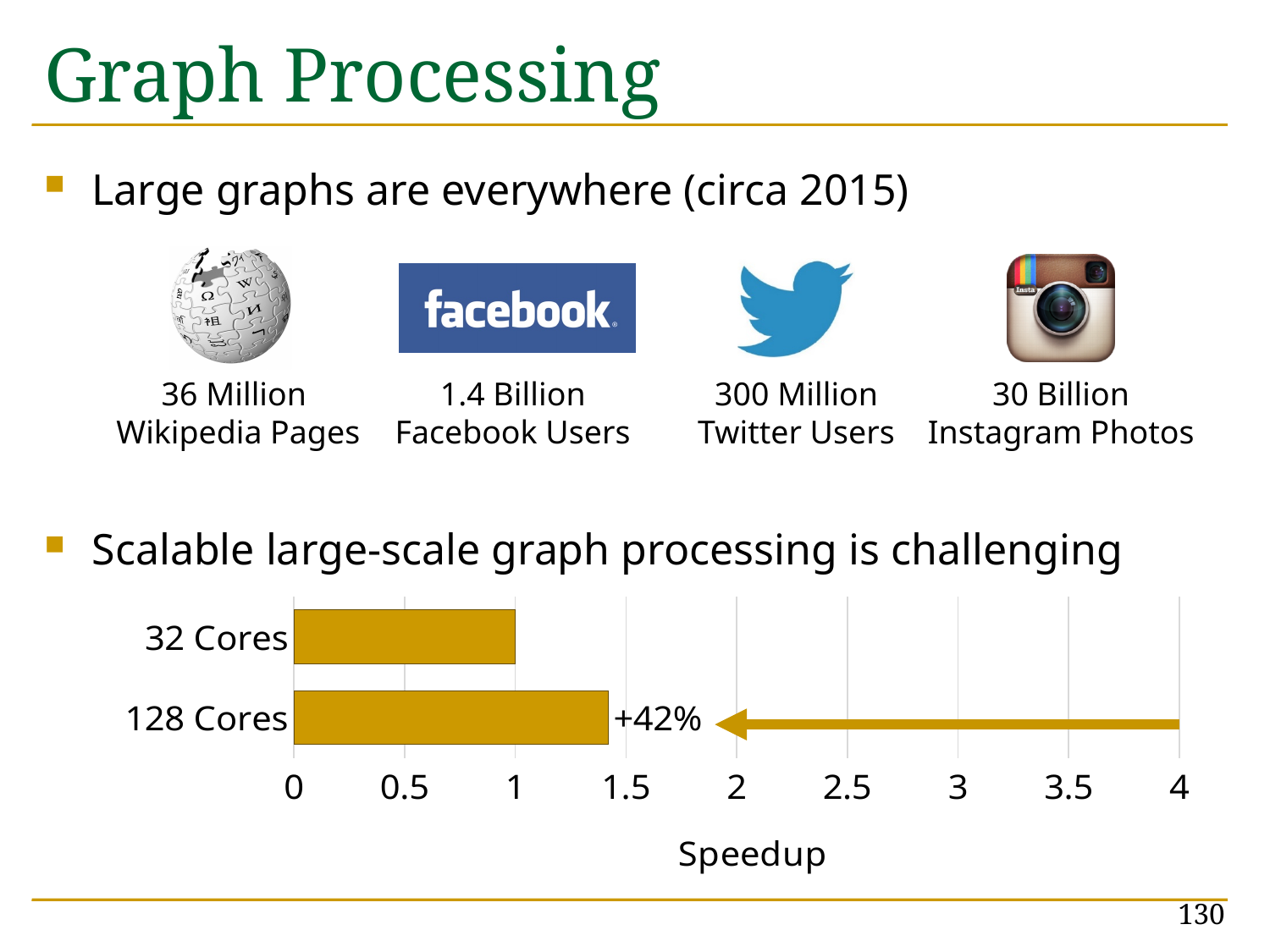
What is the maximum value shown on the x axis of the bar chart? 4 What is the title of the x axis in the bar chart? Speedup Is the speedup for 128 Cores greater or less than 2? less Which is larger in the bar chart: the speedup for 32 Cores or for 128 Cores? 128 Cores Which category has the higher speedup in the bar chart? 128 Cores What kind of chart is shown at the bottom of the slide? bar chart How many categories does the Speedup bar chart show? 2 What percentage label is shown next to the 128 Cores bar? +42% Is the speedup for 128 Cores greater or less than 1.5? less Which category has the lower speedup in the bar chart? 32 Cores Is the speedup for 128 Cores greater or less than 1? greater What is the speedup value for 32 Cores in the bar chart? 1